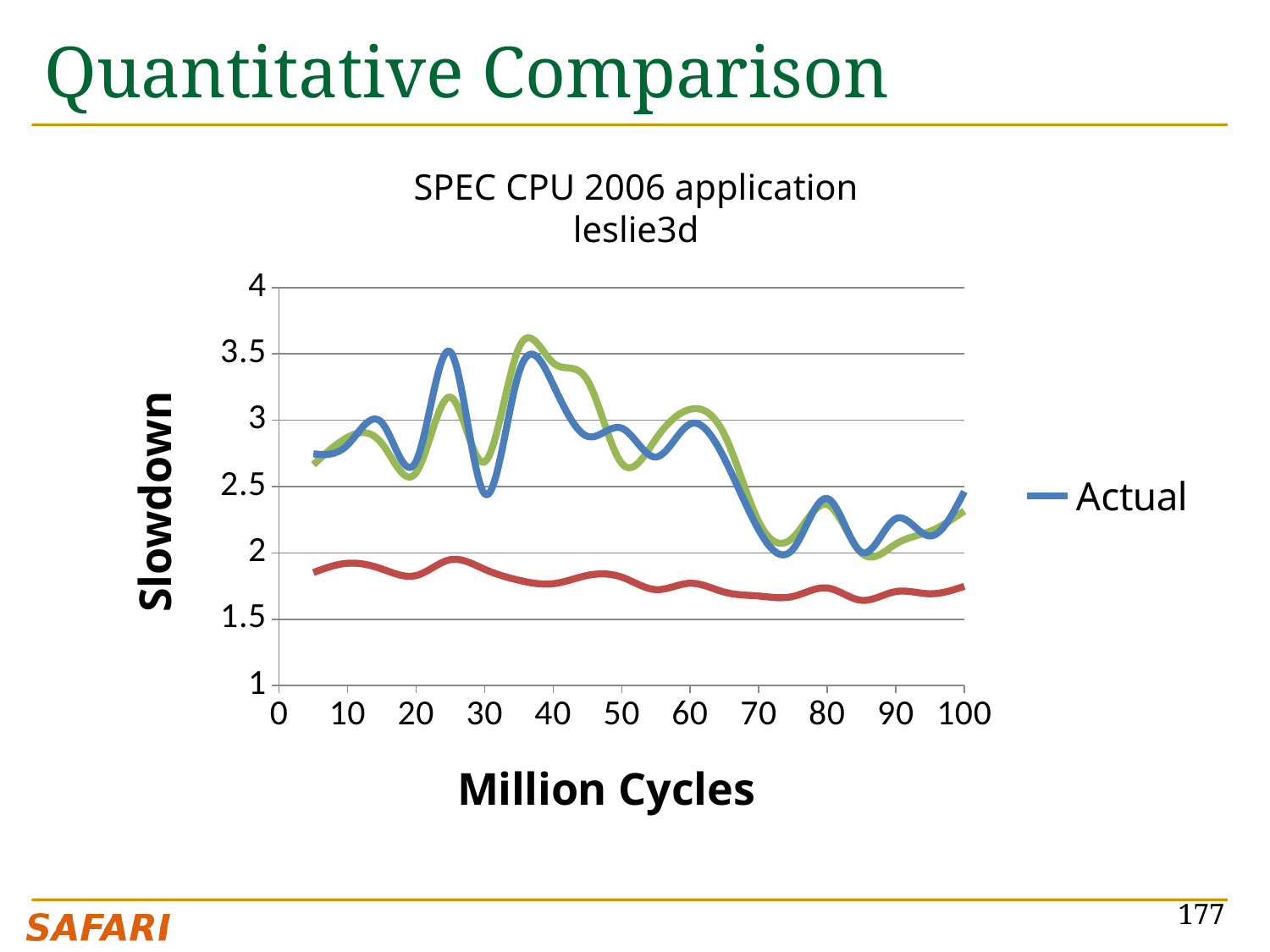
Is the Actual value at 25 million cycles greater or less than 3? greater Is the Actual value at 85 million cycles greater or less than 2.5? less Is the Actual value at 10 million cycles greater or less than 2.5? greater What kind of chart is shown on the slide? line chart Between 60 and 75 million cycles, does the Actual line rise or fall? fall What is the title of the chart? SPEC CPU 2006 application leslie3d How many series does the chart's legend list? 1 What is the label of the y axis? Slowdown Between 85 and 100 million cycles, does the Actual line rise or fall? rise